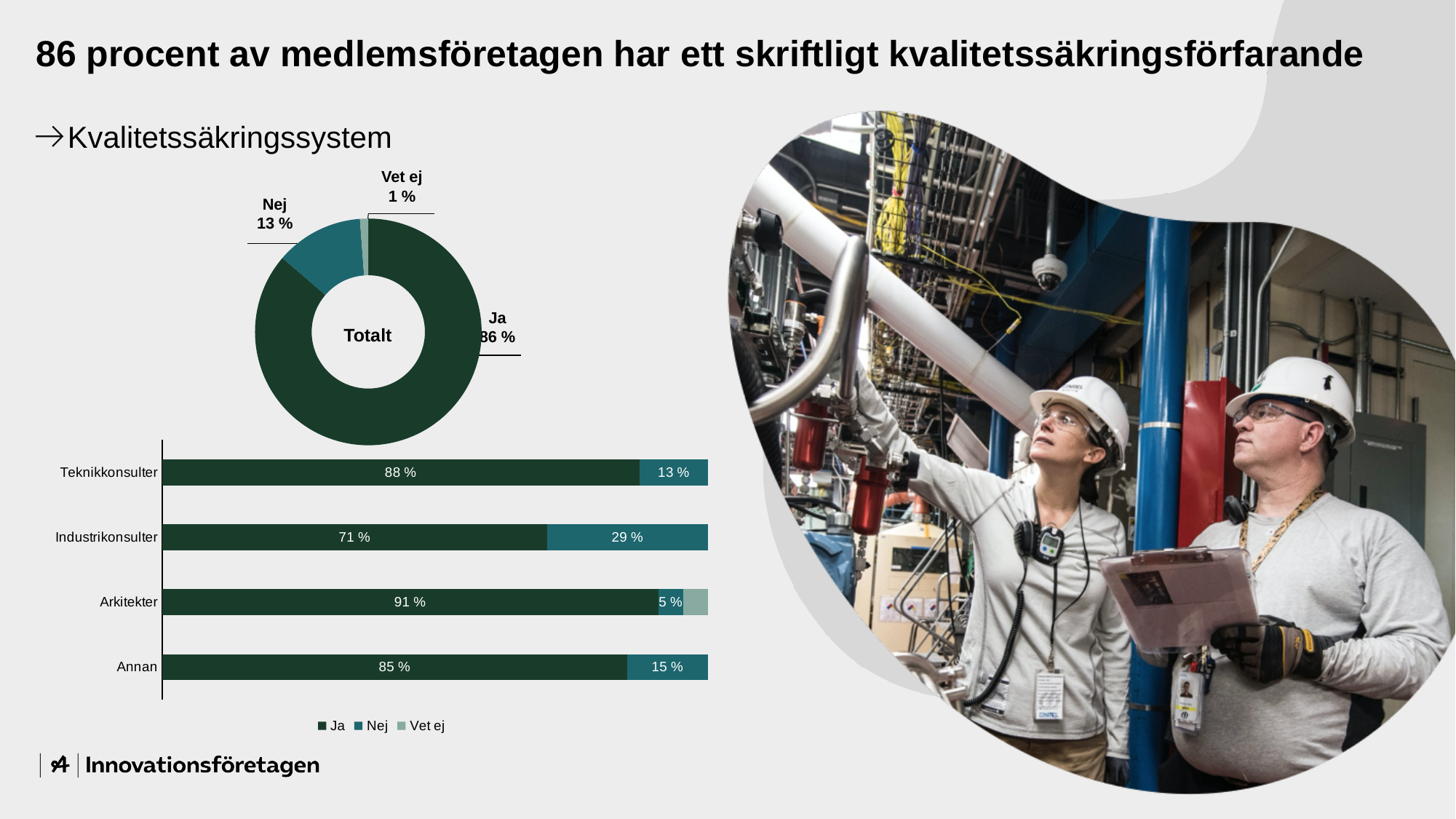
In the bar chart at the bottom left, which category has the lowest Ja value? Industrikonsulter In the bar chart at the bottom left, what is the difference between the Ja values for Arkitekter and Annan? 6 % In the bar chart at the bottom left, what is the Nej value for Teknikkonsulter? 13 % In the donut chart labelled Totalt, which answer has the smallest share? Vet ej How many categories are shown in the bar chart at the bottom left? 4 How many series does the legend of the bar chart at the bottom left list? 3 In the donut chart labelled Totalt, what share of respondents answered Nej? 13 % In the donut chart labelled Totalt, how many percentage points larger is the Ja share than the Nej share? 73 % In the bar chart at the bottom left, what is the Ja value for Industrikonsulter? 71 % In the donut chart labelled Totalt, what share of respondents answered Ja? 86 % In the bar chart at the bottom left, which category has the highest Ja value? Arkitekter In the bar chart at the bottom left, which is larger: the Nej value for Industrikonsulter or the Nej value for Annan? Industrikonsulter